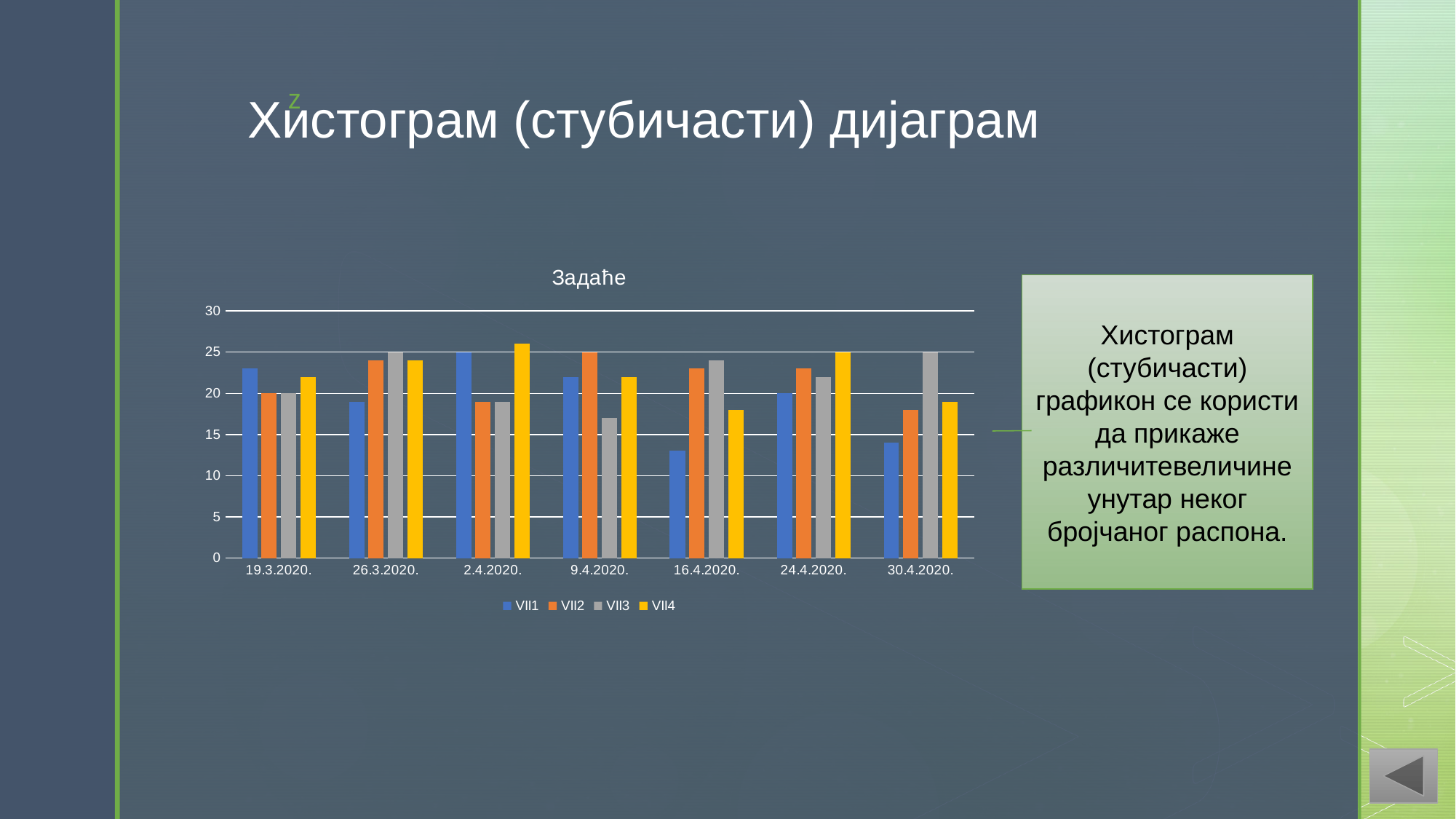
Which series is shown in yellow in the legend? VII4 Which series has the lowest value on 16.4.2020.? VII1 Which is larger: the value for VII1 on 2.4.2020. or the value for VII1 on 16.4.2020.? VII1 on 2.4.2020. Which series has the highest value on 30.4.2020.? VII3 Is the value for VII1 on 16.4.2020. greater or less than 15? less How many dates are shown on the x axis of the chart? 7 Is the value for VII1 on 30.4.2020. greater or less than 15? less What is the title of the chart? Задаће Is the value for VII3 on 9.4.2020. greater or less than 20? less What type of chart is shown on the slide? bar chart How many series does the legend list? 4